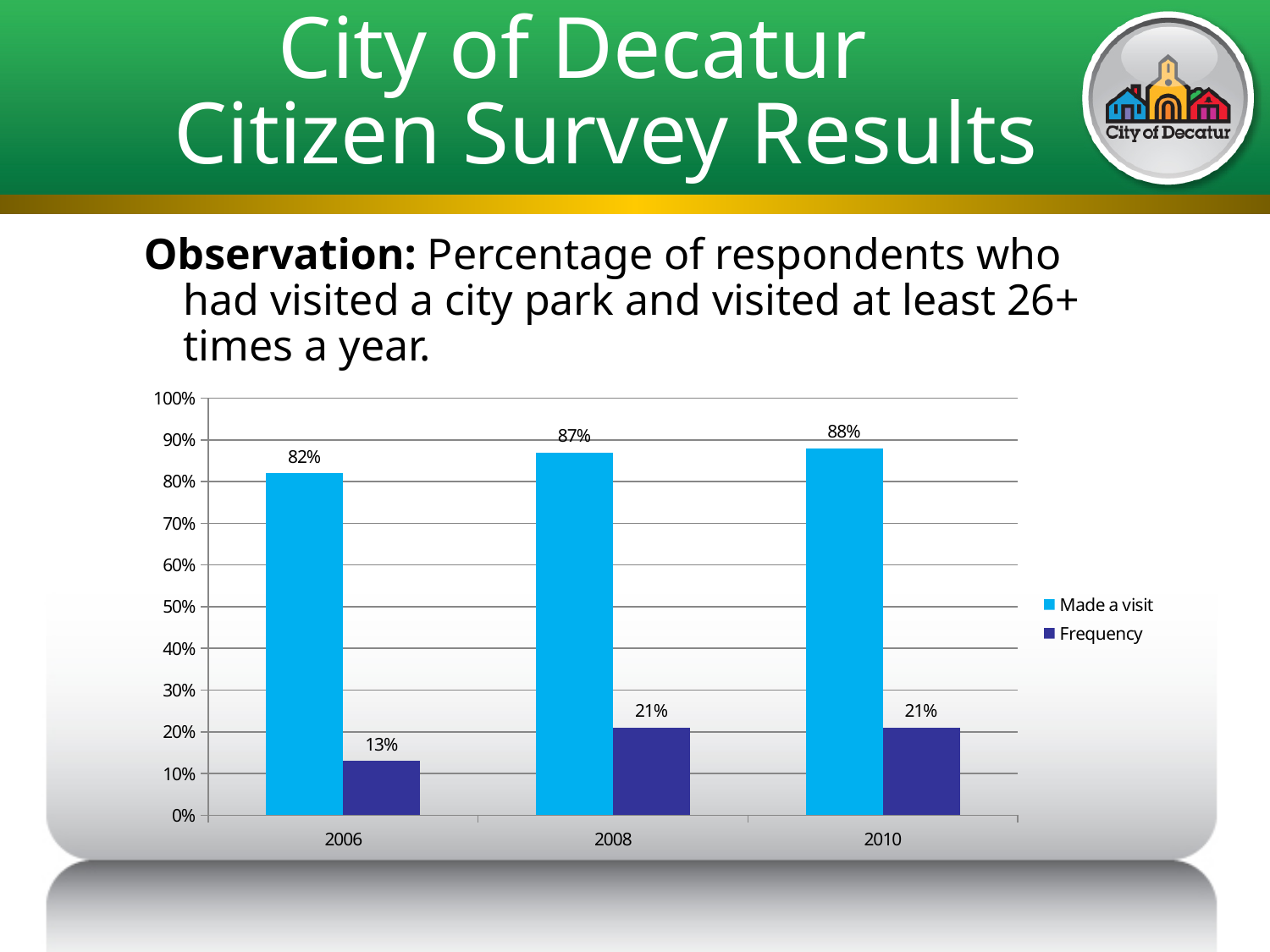
Does the "Made a visit" series rise or fall from 2006 to 2010? Rise Which is larger: "Made a visit" in 2006 or "Made a visit" in 2008? Made a visit in 2008 What is the value for "Made a visit" in 2006? 82% What is the difference between the "Made a visit" values for 2008 and 2006? 5% What is the value for "Frequency" in 2008? 21% In which year is the "Frequency" value lowest? 2006 What is the value for "Made a visit" in 2010? 88% What kind of chart is shown on the slide? Bar chart How many years are shown on the x axis? 3 In which year is the "Made a visit" value highest? 2010 How many series does the legend list? 2 What is the difference between the "Frequency" values for 2008 and 2006? 8%